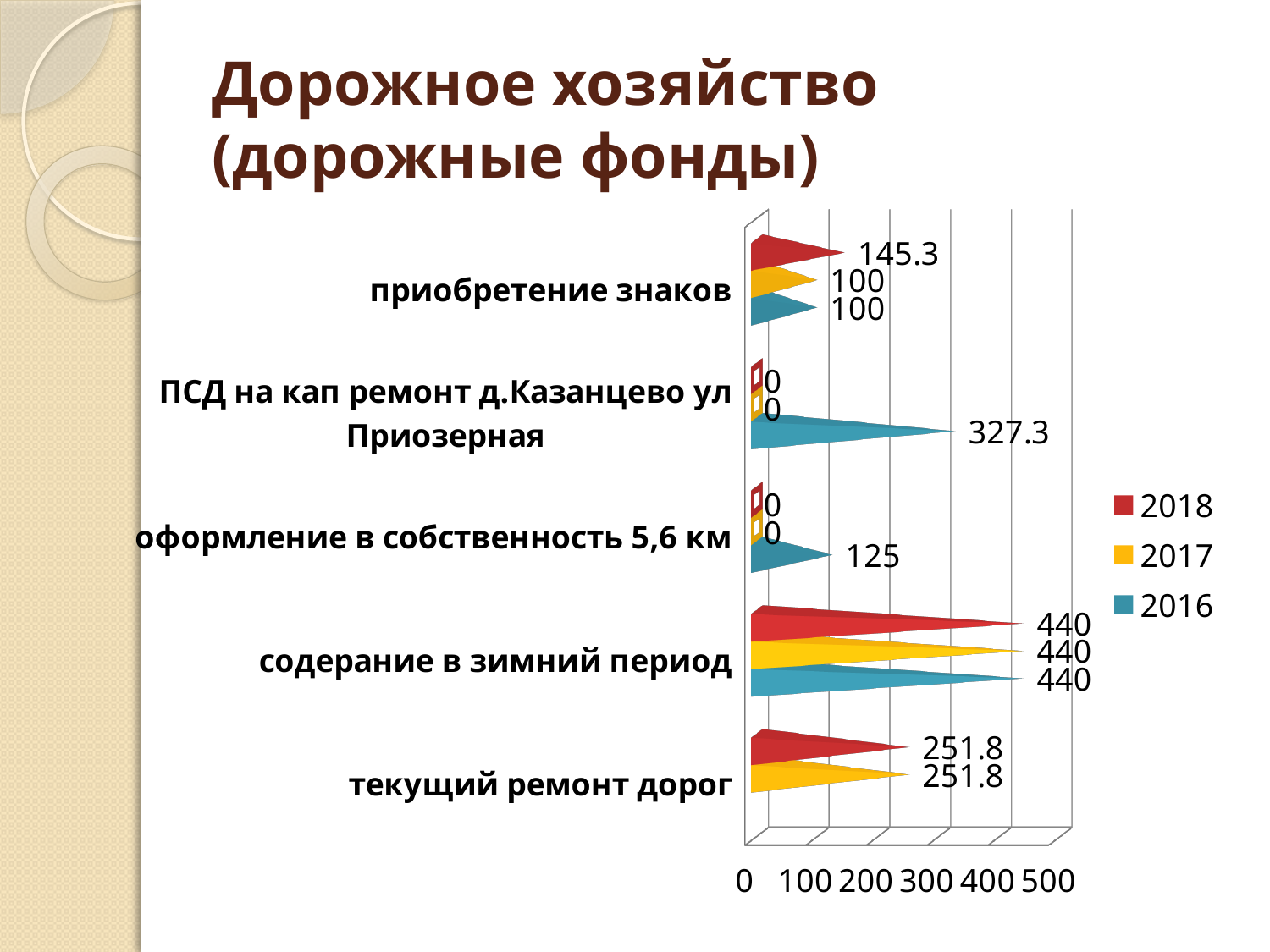
What is the difference between the 2018 and 2017 values for приобретение знаков? 45.3 How many categories are shown on the chart? 5 Which category has the highest 2016 value? содерание в зимний период What is the 2018 value for приобретение знаков? 145.3 What kind of chart is shown on the slide? bar chart What is the 2017 value for текущий ремонт дорог? 251.8 Which colour represents the 2016 series in the legend? blue How many series does the legend list? 3 Which is larger for 2016: ПСД на кап ремонт д.Казанцево ул Приозерная or оформление в собственность 5,6 км? ПСД на кап ремонт д.Казанцево ул Приозерная What is the 2016 value for ПСД на кап ремонт д.Казанцево ул Приозерная? 327.3 What is the 2016 value for оформление в собственность 5,6 км? 125 What is the 2017 value for ПСД на кап ремонт д.Казанцево ул Приозерная? 0